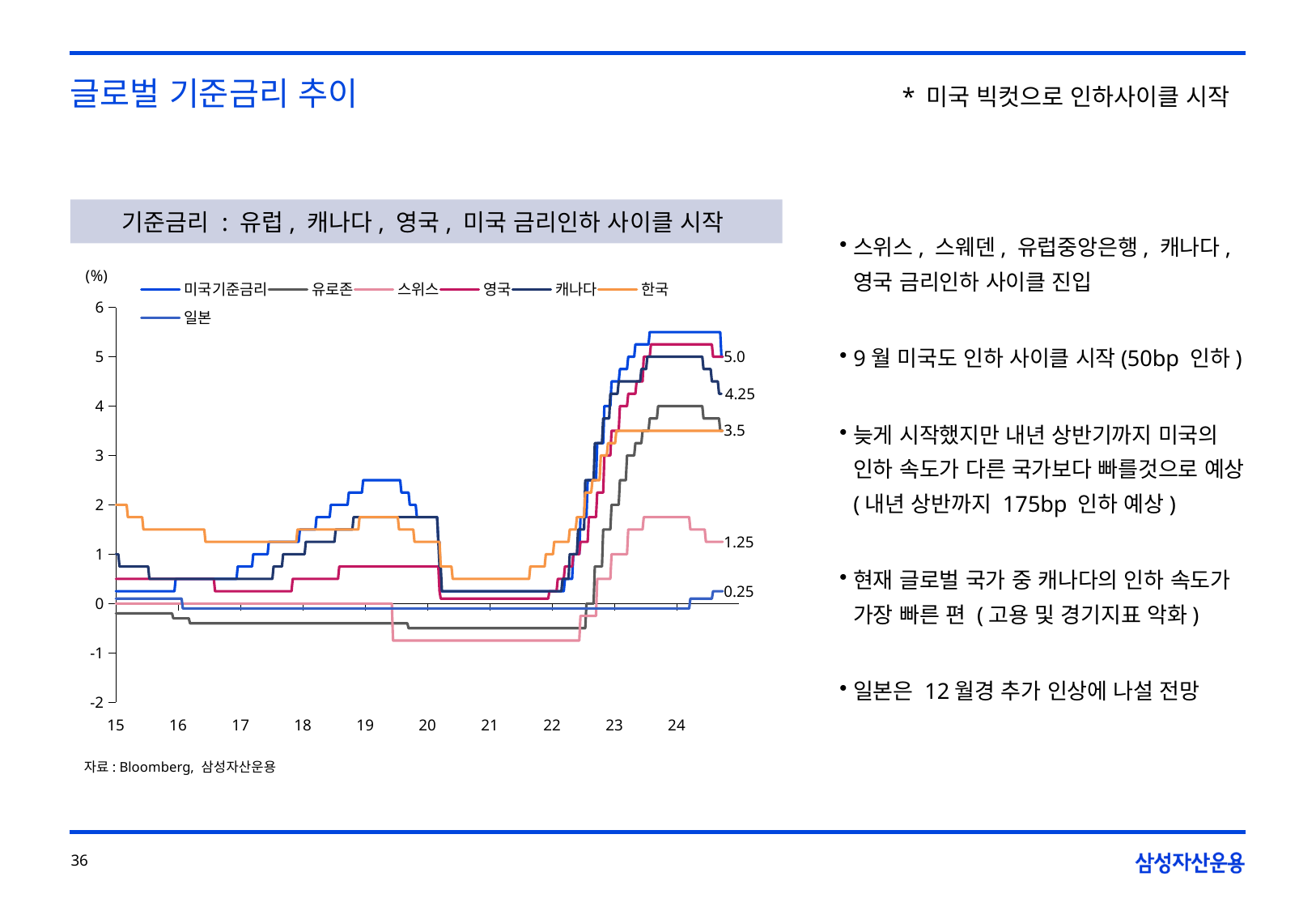
What is the latest value labelled for 캐나다 (Canada) at the right end of the chart? 4.25 What is the latest value labelled for 한국 (Korea) at the right end of the chart? 3.5 Which series reaches the highest level on the chart? 미국기준금리 What kind of chart is shown on the slide? Line chart Is the value for 스위스 around 2020 greater or less than 0? less What is the latest value labelled for 스위스 (Switzerland) at the right end of the chart? 1.25 How many year labels are shown on the x axis? 10 What is the title of the chart? 기준금리 : 유럽, 캐나다, 영국, 미국 금리인하 사이클 시작 How many series does the chart legend list? 7 Which series falls to the lowest level on the chart? 스위스 What is the latest value labelled for 일본 (Japan) at the right end of the chart? 0.25 What unit is shown on the y axis of the chart? %